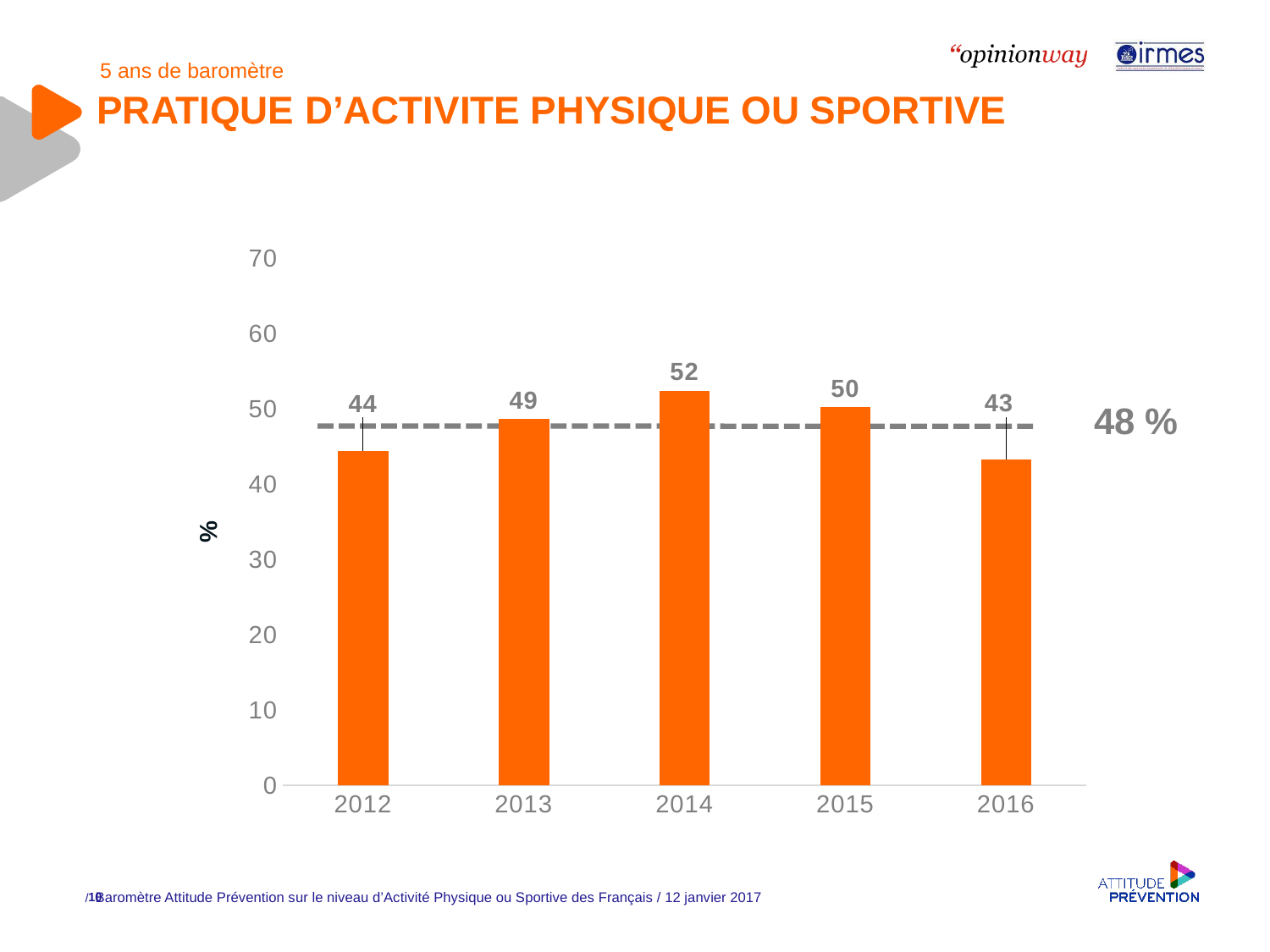
What is the difference between the values for 2014 and 2016? 9 What is the value for 2016? 43 What value is indicated by the dashed horizontal line? 48 % Which is larger, the value for 2013 or the value for 2015? 2015 What kind of chart is shown on the slide? bar chart Which year has the lowest value? 2016 What is the value for 2014? 52 Is the value for 2012 greater or less than 50? less Which year has the highest value? 2014 What is the value for 2012? 44 How many years are shown on the x axis? 5 What is the label on the y axis? %